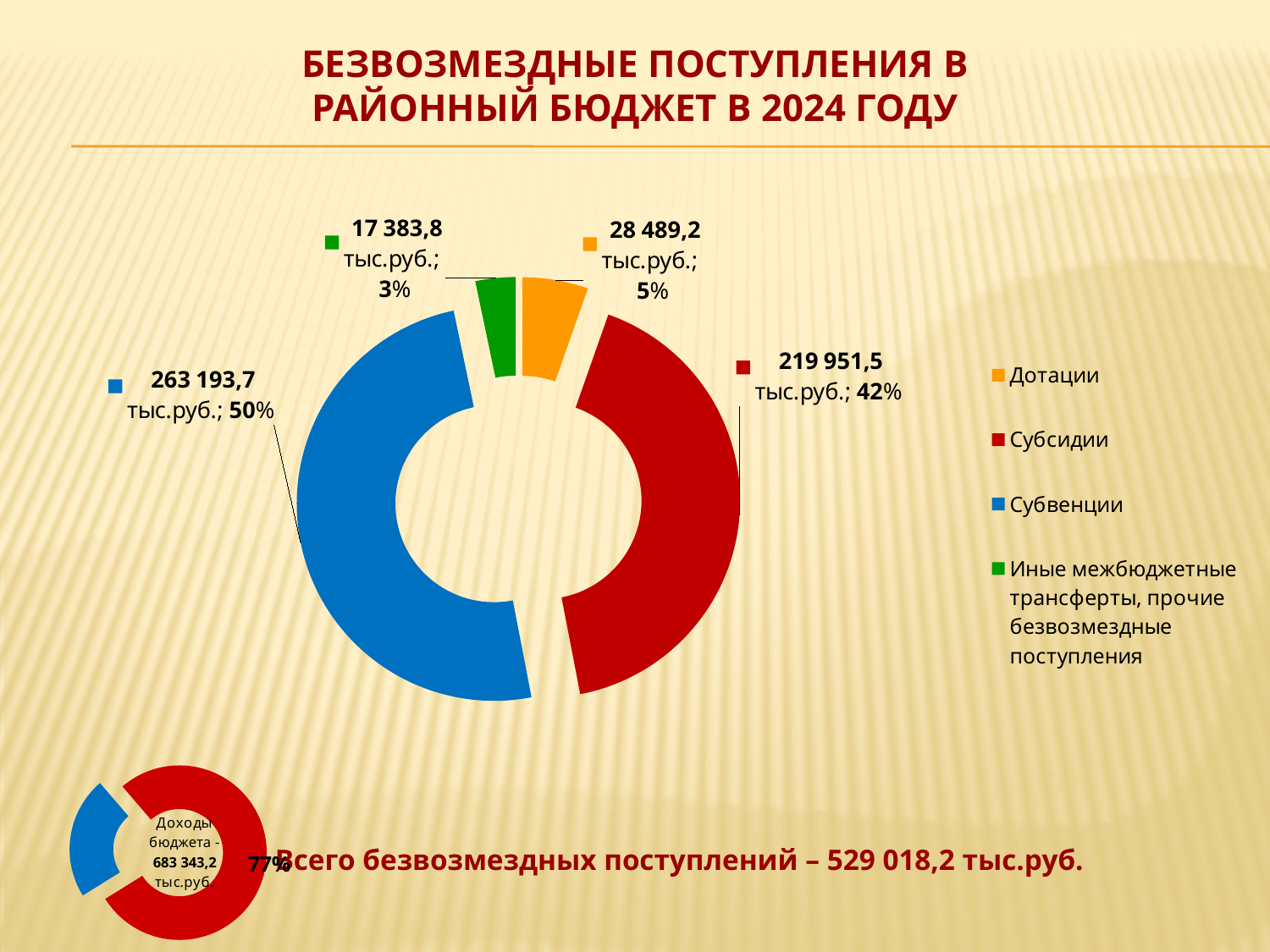
How many categories does the legend of the large doughnut chart list? 4 On the large doughnut chart, which colour represents Субвенции? Blue On the large doughnut chart, what value is shown for Дотации? 28 489,2 тыс.руб. On the large doughnut chart, what percentage share is shown for Субсидии? 42% On the large doughnut chart, which category has the smallest value? Иные межбюджетные трансферты, прочие безвозмездные поступления On the large doughnut chart, what value is shown for Субвенции? 263 193,7 тыс.руб. On the large doughnut chart, which category has the largest value? Субвенции On the large doughnut chart, what value is shown for Субсидии? 219 951,5 тыс.руб. On the large doughnut chart, what percentage share is shown for Иные межбюджетные трансферты, прочие безвозмездные поступления? 3% On the large doughnut chart, which is larger: Дотации or Субсидии? Субсидии What type of chart is the large chart in the centre of the slide? Doughnut chart On the large doughnut chart, what is the difference in percentage points between the shares of Субвенции and Субсидии? 8%